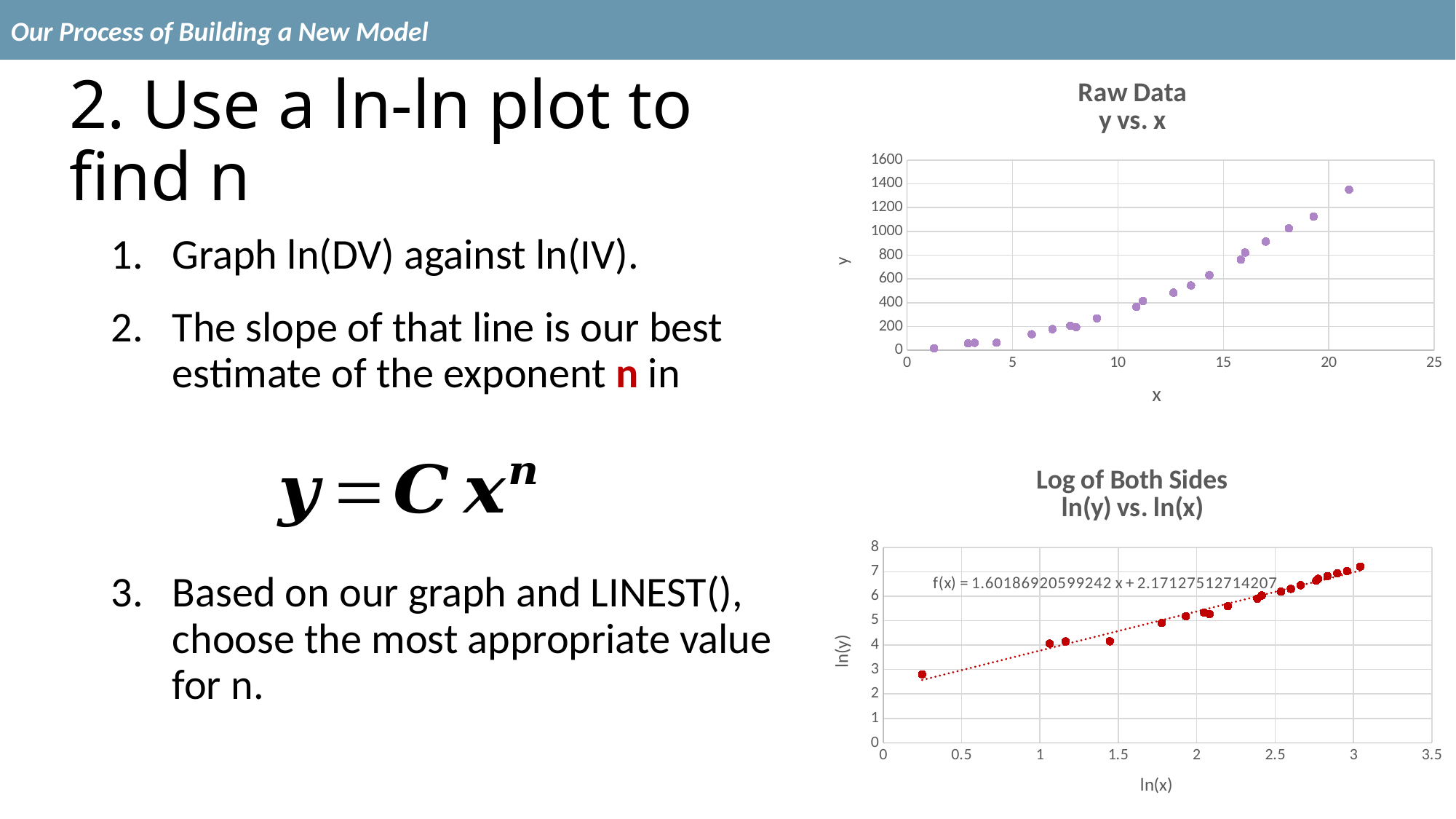
What kind of chart is the "Log of Both Sides ln(y) vs. ln(x)" chart? scatter chart In the "Log of Both Sides ln(y) vs. ln(x)" chart, is the ln(y) value of the rightmost point (near ln(x) = 3) greater or less than 6? greater In the "Log of Both Sides ln(y) vs. ln(x)" chart, do the ln(y) values rise or fall as ln(x) increases? rise What is the label of the vertical axis on the "Log of Both Sides" chart? ln(y) In the "Raw Data y vs. x" chart, is the y value of the point near x = 4 greater or less than 200? less What is the trendline equation shown on the "Log of Both Sides ln(y) vs. ln(x)" chart? f(x) = 1.60186920599242 x + 2.17127512714207 In the "Raw Data y vs. x" chart, which point has the higher y value: the one near x = 10 or the one near x = 20? the one near x = 20 In the "Raw Data y vs. x" chart, is the y value of the rightmost point (near x = 21) greater or less than 1200? greater In the "Raw Data y vs. x" chart, do the y values rise or fall as x increases? rise What kind of chart is the "Raw Data y vs. x" chart? scatter chart